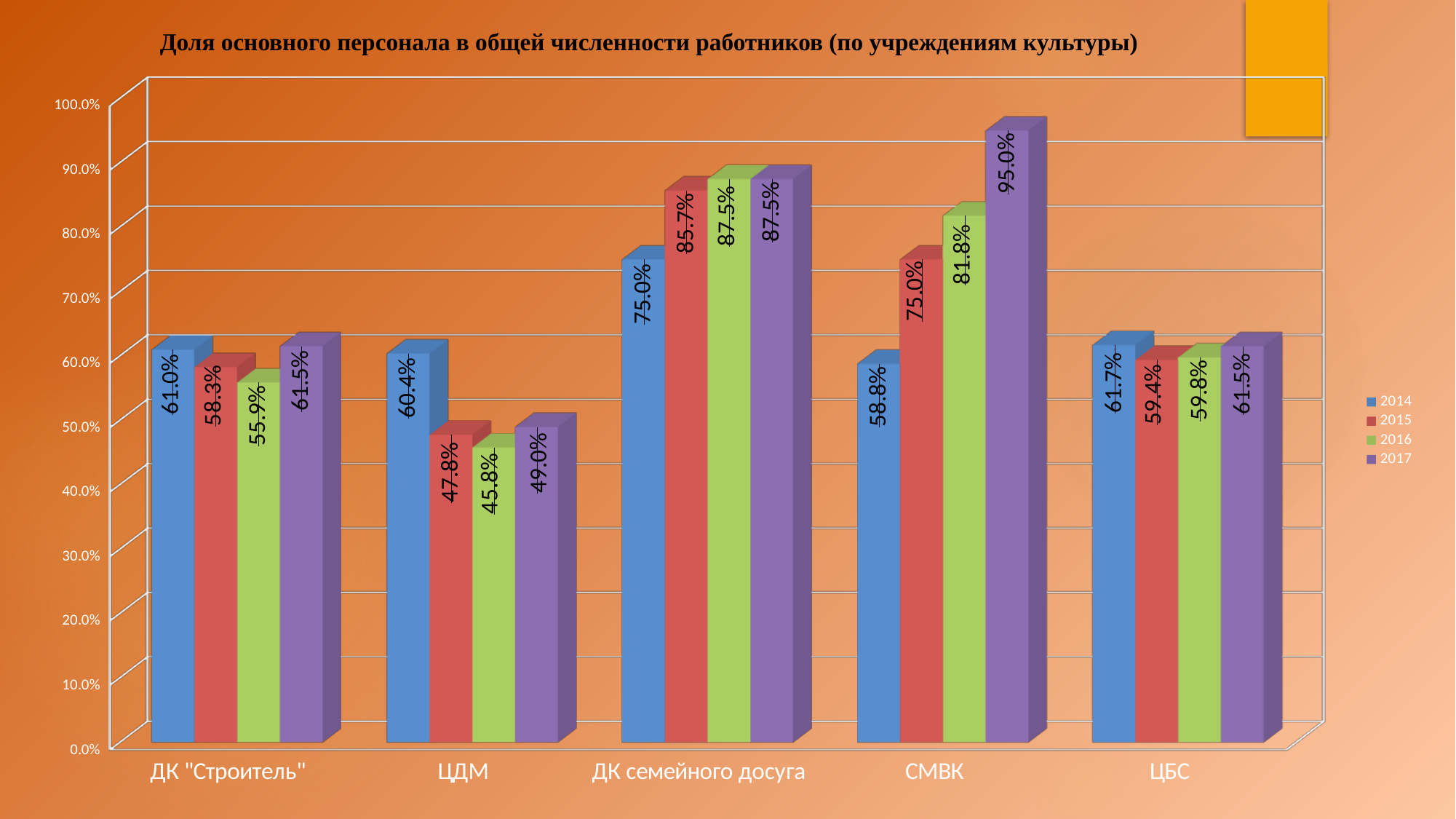
Which is larger: the 2014 value for ДК "Строитель" or the 2014 value for ЦБС? ЦБС What is the value for ДК семейного досуга in 2014? 75.0% Which category has the lowest value in 2015? ЦДМ What is the value for СМВК in 2017? 95.0% Do the values for СМВК rise or fall from 2014 to 2017? Rise How many series does the legend list? 4 What is the value for ЦБС in 2015? 59.4% What kind of chart is shown on the slide? Bar chart What is the difference between the 2017 and 2014 values for СМВК? 36.2% How many categories are shown on the x axis? 5 What is the value for ЦДМ in 2016? 45.8% Which category has the highest value in 2017? СМВК